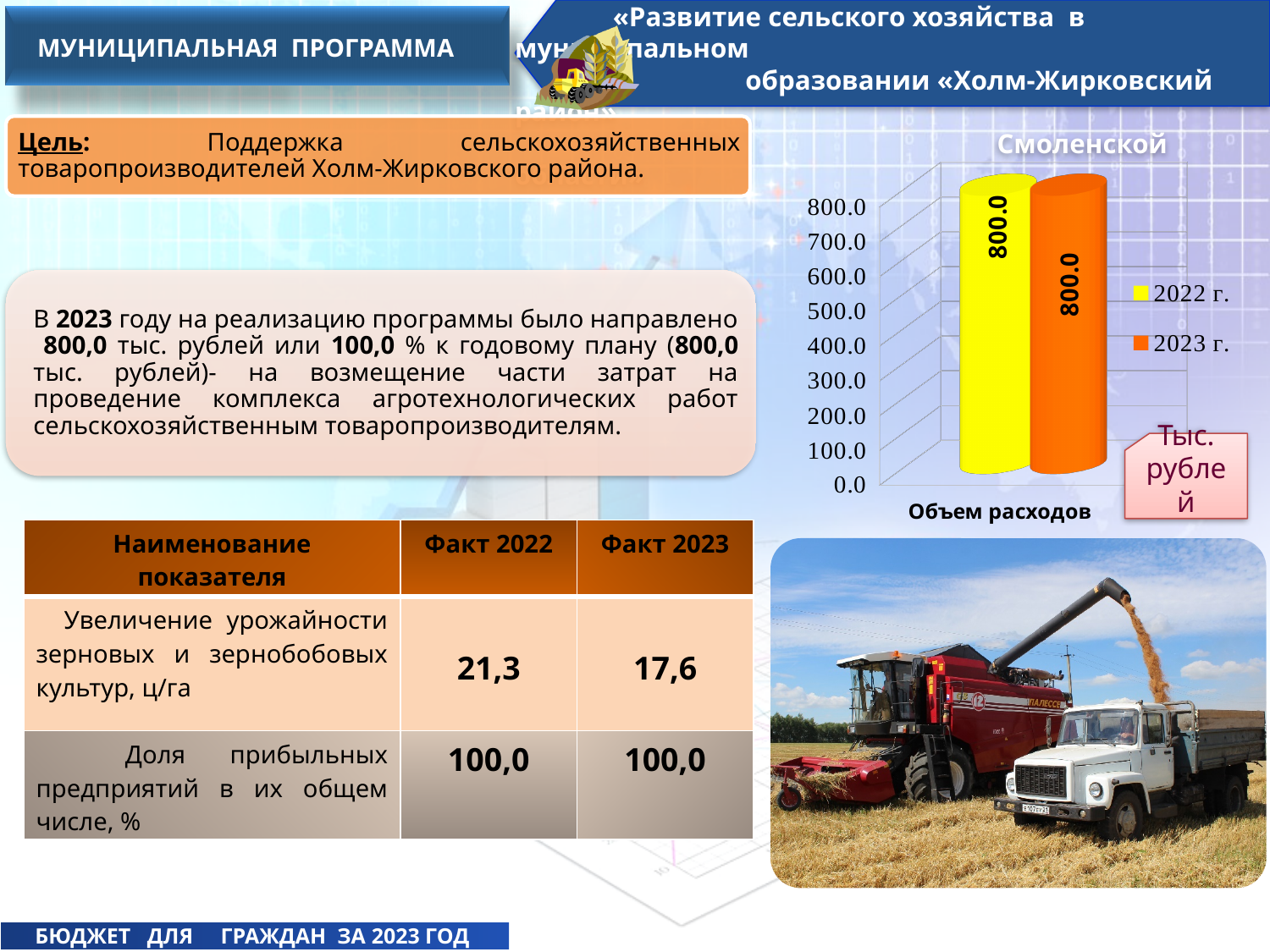
How many series does the chart legend list? 2 What is the value for 2023 г. in the chart? 800.0 Is the value for 2022 г. greater or less than 700.0? greater What is the value for 2022 г. in the chart? 800.0 What kind of chart is shown on the slide? bar chart Which colour represents 2023 г. in the chart? orange What is the difference between the 2023 г. value and the 2022 г. value in the chart? 0.0 What is the category label on the x axis of the chart? Объем расходов How many categories are shown on the x axis of the chart? 1 Is the value for 2023 г. greater or less than 500.0? greater